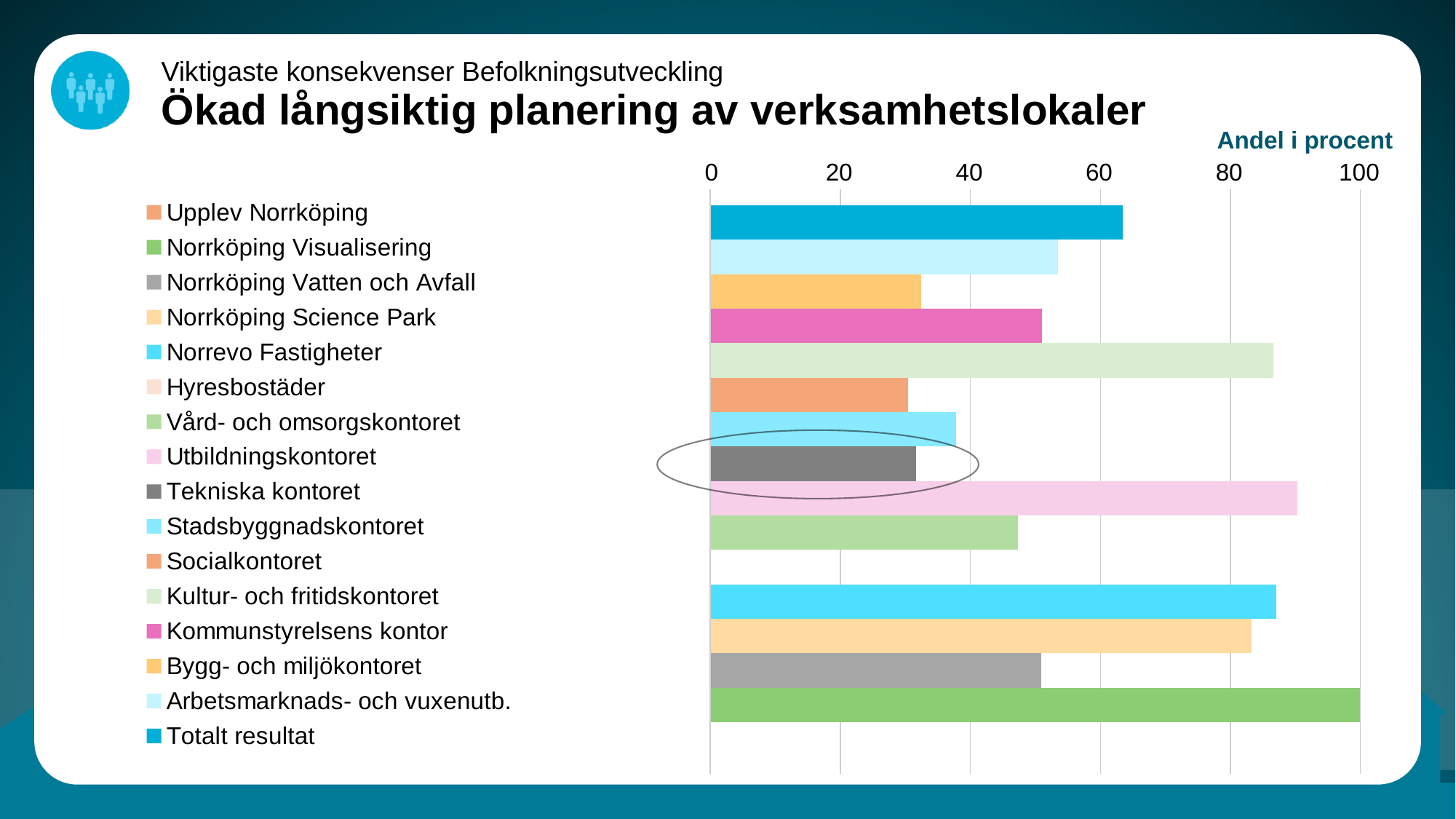
How many entries does the legend list? 16 Is the value for Socialkontoret greater or less than 40? less Is the value for Totalt resultat greater or less than 80? less Which has the larger value, Utbildningskontoret or Socialkontoret? Utbildningskontoret Which legend entry has the longest bar? Norrköping Visualisering What is the axis title shown above the horizontal axis? Andel i procent Is the value for Utbildningskontoret greater or less than 80? greater What kind of chart is shown on the slide? bar chart Which legend entry's bar is highlighted with an ellipse on the chart? Tekniska kontoret What value does the bar for Norrköping Visualisering reach on the axis? 100